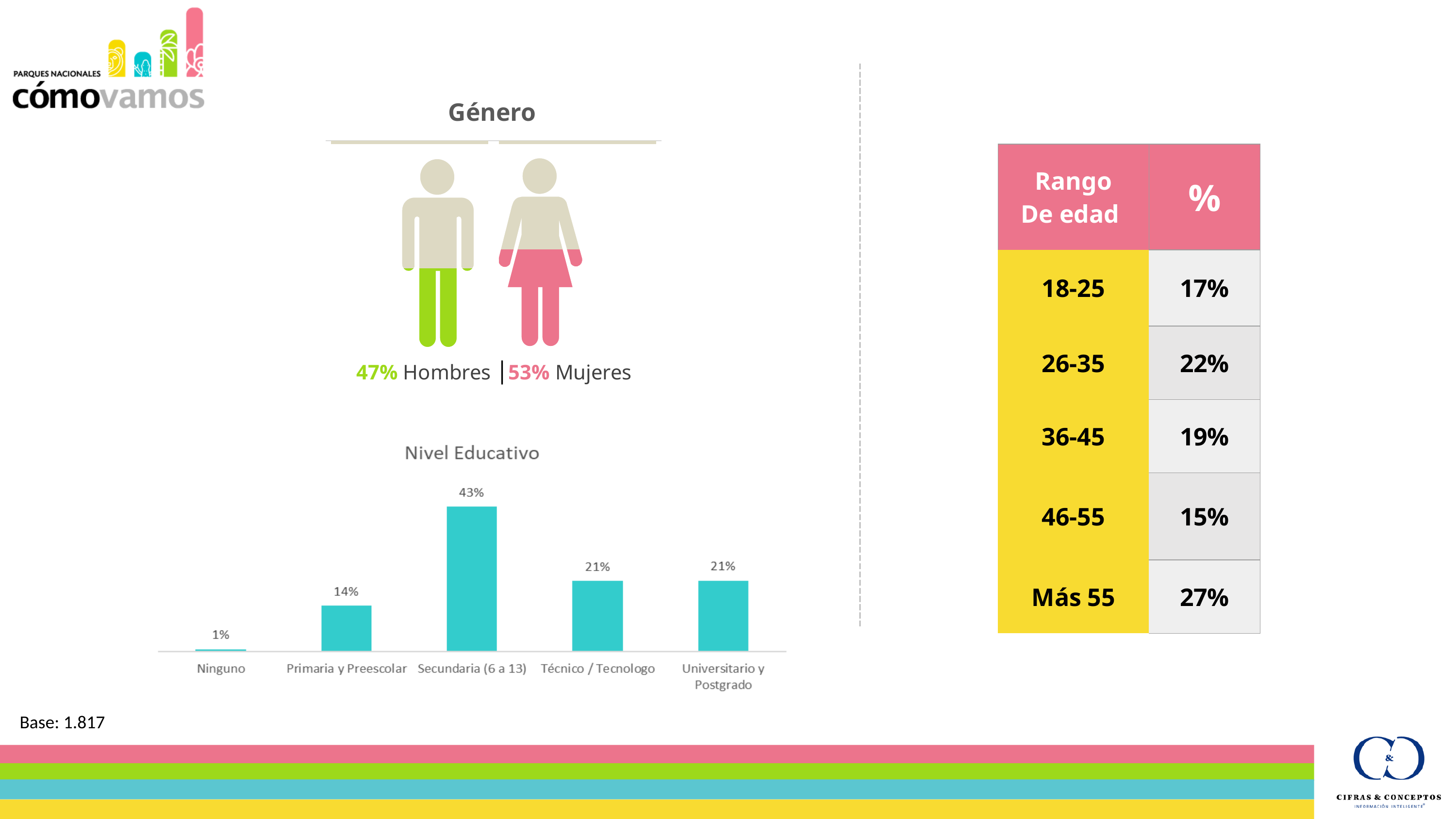
In the Nivel Educativo chart, which category has the highest value? Secundaria (6 a 13) In the Género graphic, what is the difference between Mujeres and Hombres? 6% In the Nivel Educativo chart, which is larger: Primaria y Preescolar or Universitario y Postgrado? Universitario y Postgrado In the Género graphic, what percentage are Hombres? 47% How many categories does the Nivel Educativo chart show? 5 In the Nivel Educativo chart, what is the difference between Secundaria (6 a 13) and Técnico / Tecnologo? 22% In the Nivel Educativo chart, what is the value for Primaria y Preescolar? 14% What is the title of the bar chart on the slide? Nivel Educativo In the Nivel Educativo chart, what is the value for Ninguno? 1% What kind of chart is the Nivel Educativo chart? Bar chart In the Nivel Educativo chart, what is the value for Secundaria (6 a 13)? 43% In the Nivel Educativo chart, which category has the lowest value? Ninguno